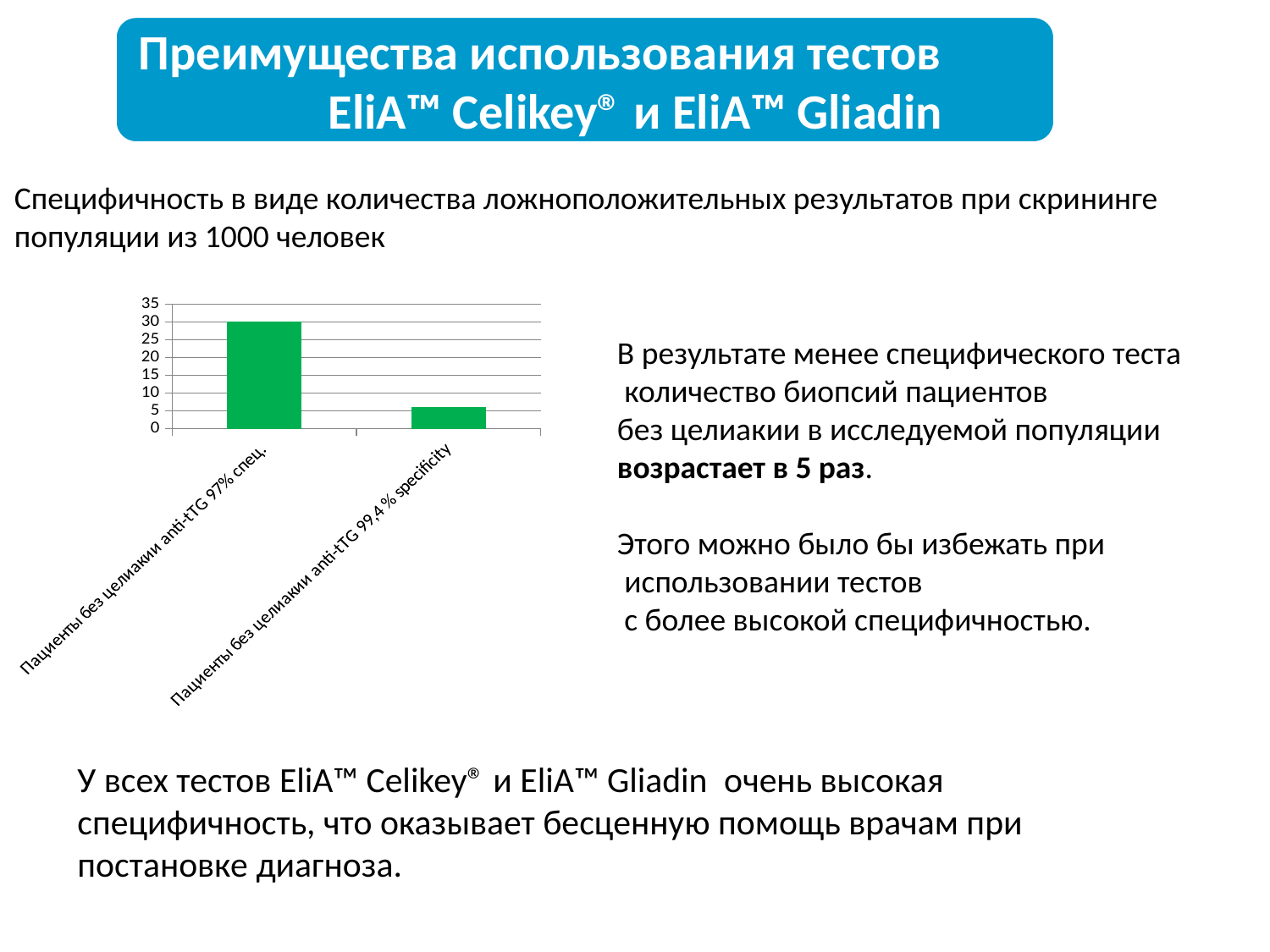
Is the value for 'Пациенты без целиакии anti-tTG 99,4 % specificity' greater or less than 10? less Is the value for 'Пациенты без целиакии anti-tTG 97% спец.' greater or less than 25? greater What is the highest value shown on the vertical axis of the chart? 35 How many bars (categories) does the chart show? 2 What is the value for 'Пациенты без целиакии anti-tTG 97% спец.'? 30 Do the values fall or rise from the left bar to the right bar? fall What kind of chart is shown on the slide? bar chart What colour are the bars in the chart? green Which is larger: the value for 'Пациенты без целиакии anti-tTG 97% спец.' or for 'Пациенты без целиакии anti-tTG 99,4 % specificity'? Пациенты без целиакии anti-tTG 97% спец. Is the value for 'Пациенты без целиакии anti-tTG 97% спец.' greater or less than 35? less Which category has the highest value in the chart? Пациенты без целиакии anti-tTG 97% спец. Which category has the lowest value in the chart? Пациенты без целиакии anti-tTG 99,4 % specificity